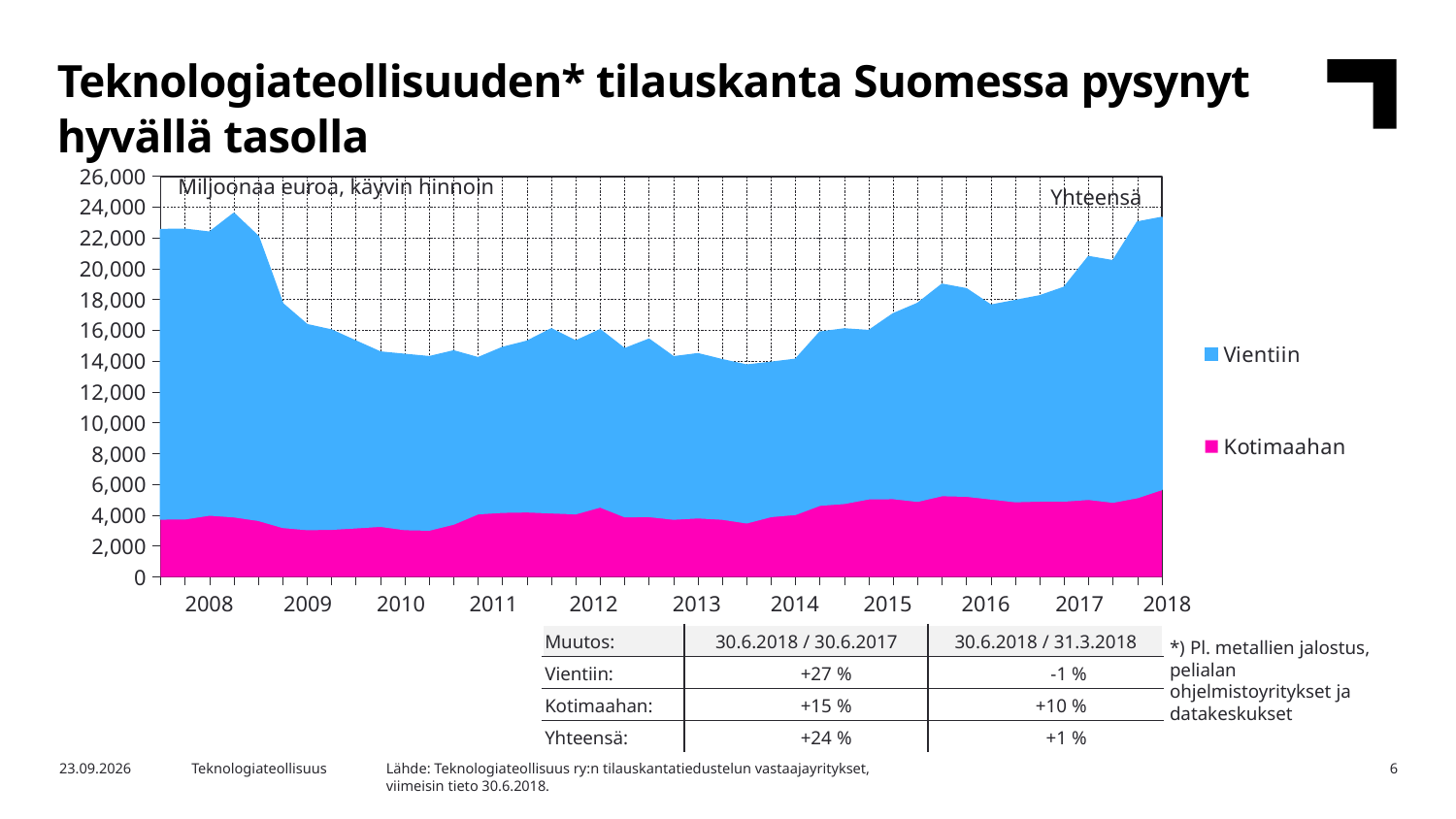
How many year labels are shown on the x axis? 11 Is the total (Yhteensä) value at the start of 2014 greater or less than 16,000? less Is the Kotimaahan value at the start of 2010 greater or less than 4,000? less Which is larger, the total (Yhteensä) at the start of 2008 or at the start of 2013? 2008 Does the total (Yhteensä) rise or fall from 2016 to 2018? rise What kind of chart is shown on the slide? area chart What unit label is printed inside the chart area? Miljoonaa euroa, käyvin hinnoin Is the Kotimaahan value at the end of the series in 2018 greater or less than 4,000? greater Does the total (Yhteensä) rise or fall from 2008 to 2010? fall Which two series are listed in the chart legend? Vientiin and Kotimaahan How many series does the chart legend list? 2